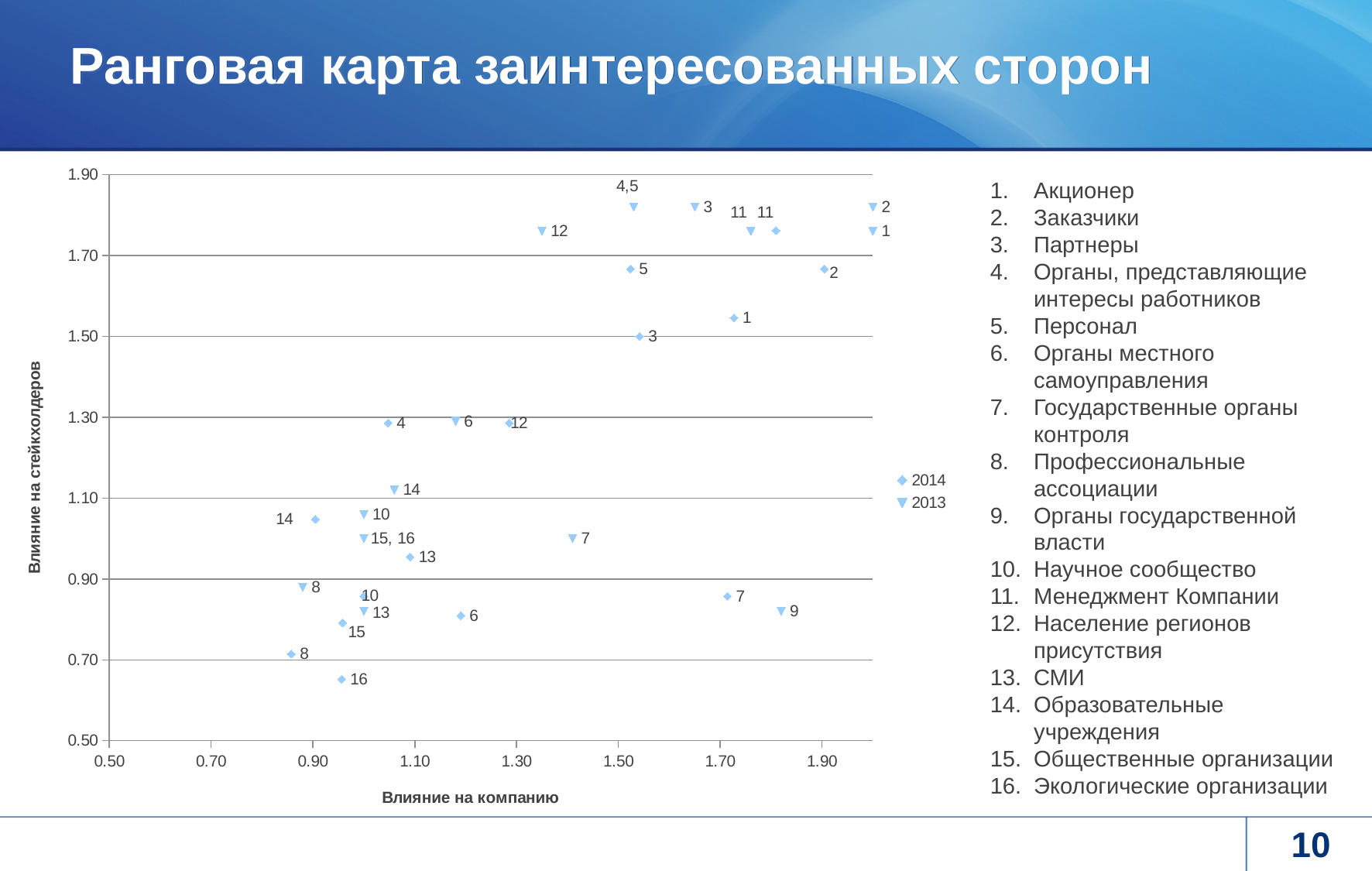
What are the two series named in the chart legend? 2014 and 2013 Is the horizontal-axis value for point 2 in the 2014 series greater or less than 1.70? greater What is the title of the horizontal axis of the chart? Влияние на компанию In the 2014 series, which point has the higher vertical-axis value, point 5 or point 3? Point 5 Is the vertical-axis value for point 12 in the 2013 series greater or less than 1.70? greater For point 7, which series has the larger horizontal-axis value, 2014 or 2013? 2014 What kind of chart is shown on the slide? Scatter chart How many series does the chart legend list? 2 Which point in the 2014 series has the lowest vertical-axis value? 16 Is the vertical-axis value for point 16 in the 2014 series greater or less than 0.70? less